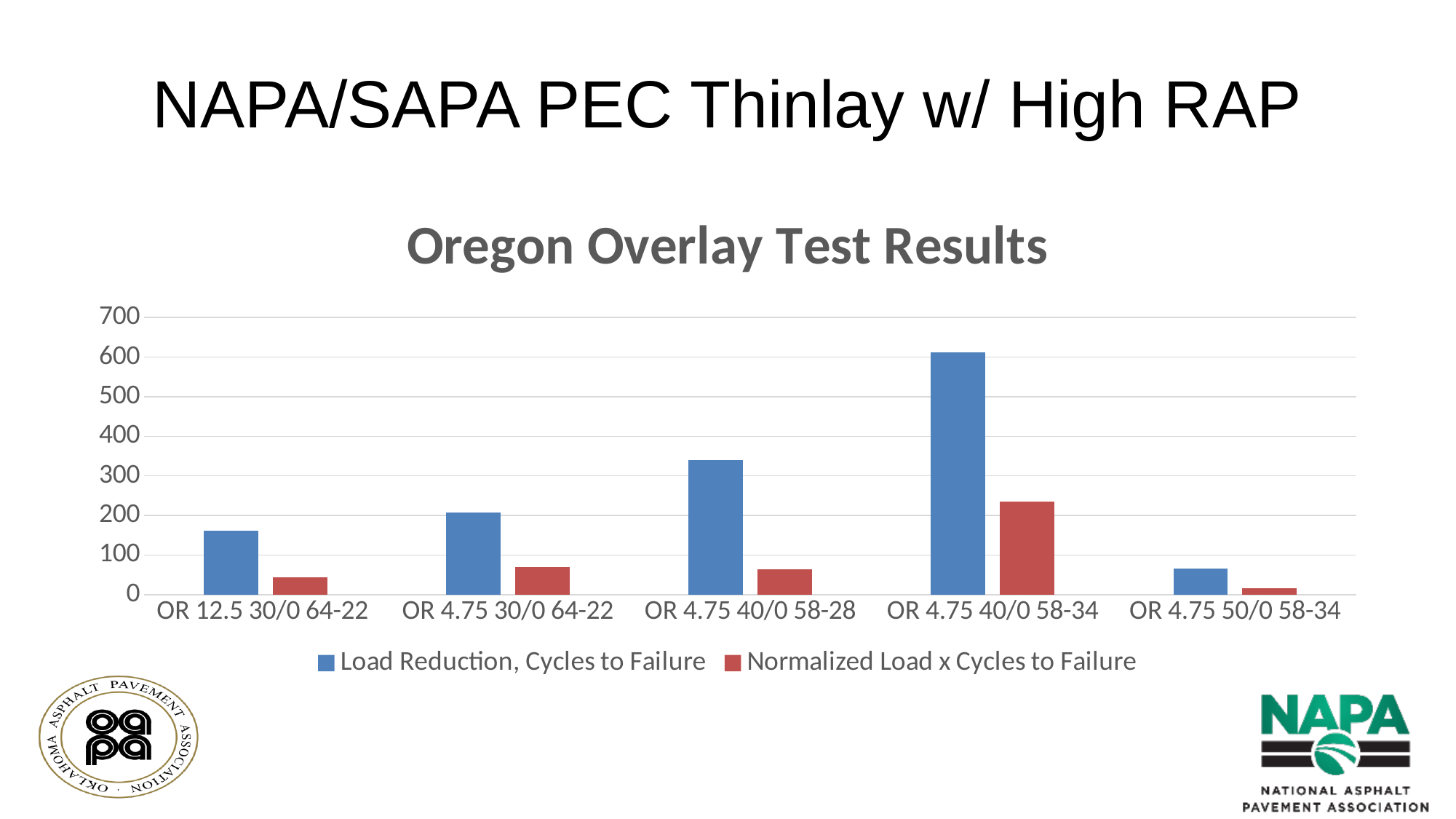
Which category has the highest value for Normalized Load x Cycles to Failure? OR 4.75 40/0 58-34 Which category has the lowest value for Load Reduction, Cycles to Failure? OR 4.75 50/0 58-34 How many series does the legend list? 2 What type of chart is shown on the slide? bar chart Is the Load Reduction, Cycles to Failure value for OR 4.75 40/0 58-28 greater or less than 300? greater Which category has the highest value for Load Reduction, Cycles to Failure? OR 4.75 40/0 58-34 What is the title of the chart? Oregon Overlay Test Results Which category has the lowest value for Normalized Load x Cycles to Failure? OR 4.75 50/0 58-34 How many categories are shown on the x axis? 5 Which is larger for OR 12.5 30/0 64-22: Load Reduction, Cycles to Failure or Normalized Load x Cycles to Failure? Load Reduction, Cycles to Failure Is the Normalized Load x Cycles to Failure value for OR 4.75 40/0 58-34 greater or less than 200? greater